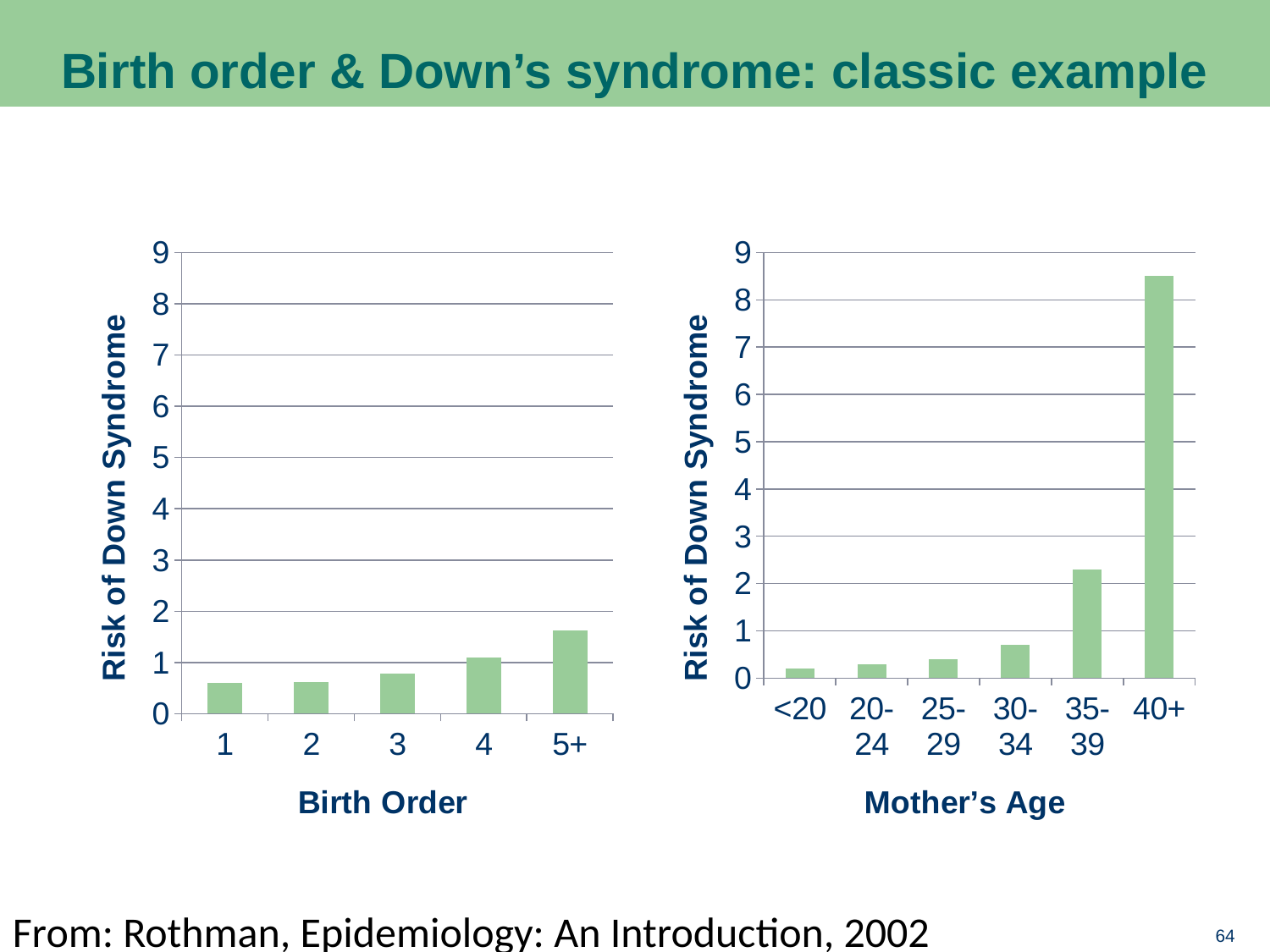
On the Mother's Age chart, which is larger, the value for 30-34 or the value for 35-39? 35-39 On the Mother's Age chart, do the values rise or fall as mother's age increases? rise On the Mother's Age chart, which age group has the highest risk of Down syndrome? 40+ On the Mother's Age chart, is the value for 40+ greater or less than 8? greater What is the y-axis title of the Birth Order chart? Risk of Down Syndrome On the Birth Order chart, is the value for birth order 3 greater or less than 1? less On the Birth Order chart, is the value for birth order 5+ greater or less than 1? greater On the Birth Order chart, which birth order has the highest risk of Down syndrome? 5+ How many mother's age categories are shown on the right chart? 6 What kind of chart is the Birth Order chart on the left? bar chart How many birth order categories are shown on the left chart? 5